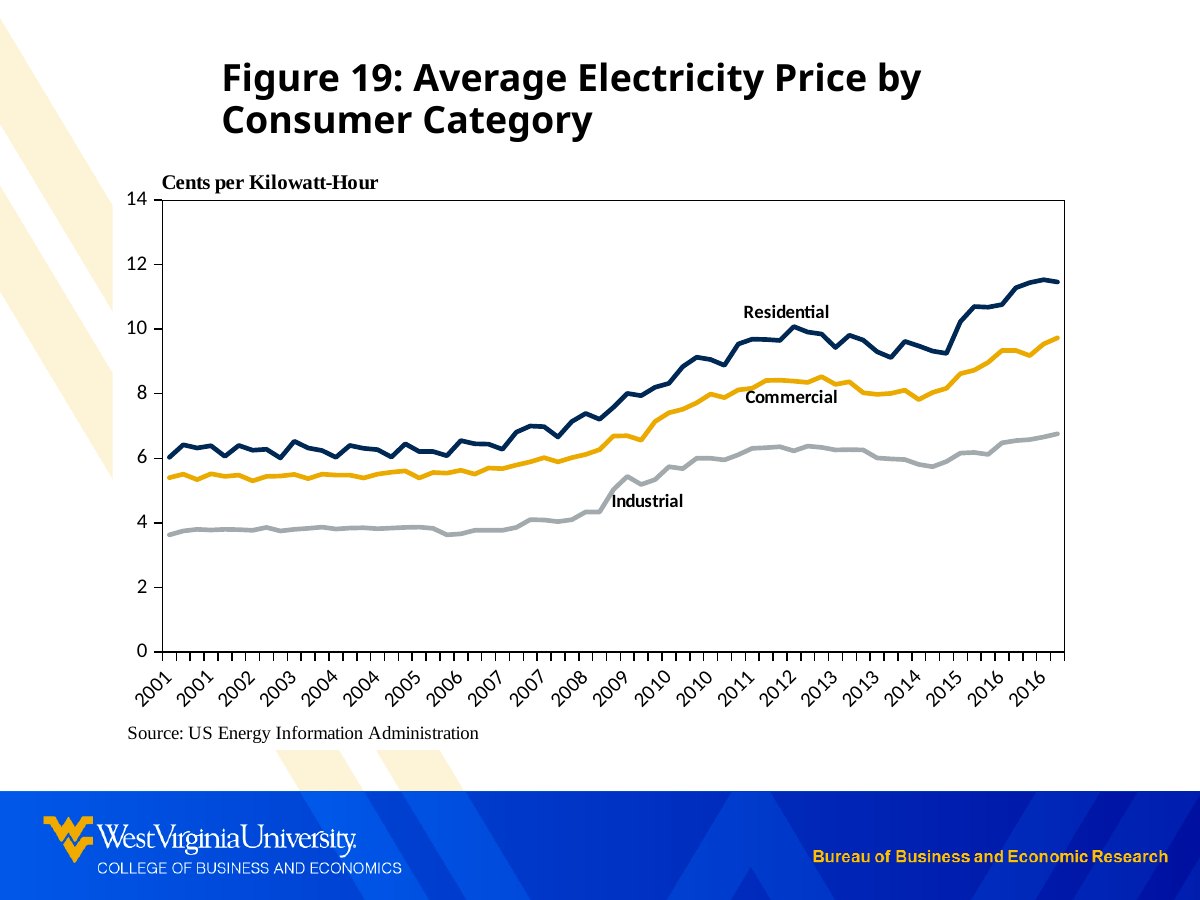
Which is larger in 2016, the Commercial value or the Industrial value? Commercial Is the Commercial value at the end of 2016 greater or less than 8? greater Do the Residential prices generally rise or fall from 2001 to 2016? rise Is the Commercial value at the start of 2001 greater or less than 6? less What kind of chart is shown on the slide? line chart Is the Residential value at the end of 2016 greater or less than 10? greater Which series has the lowest values throughout the chart? Industrial How many series are plotted on the chart? 3 Which series has the highest values throughout the chart? Residential What unit is shown on the vertical axis label? Cents per Kilowatt-Hour What is the title of the chart? Figure 19: Average Electricity Price by Consumer Category